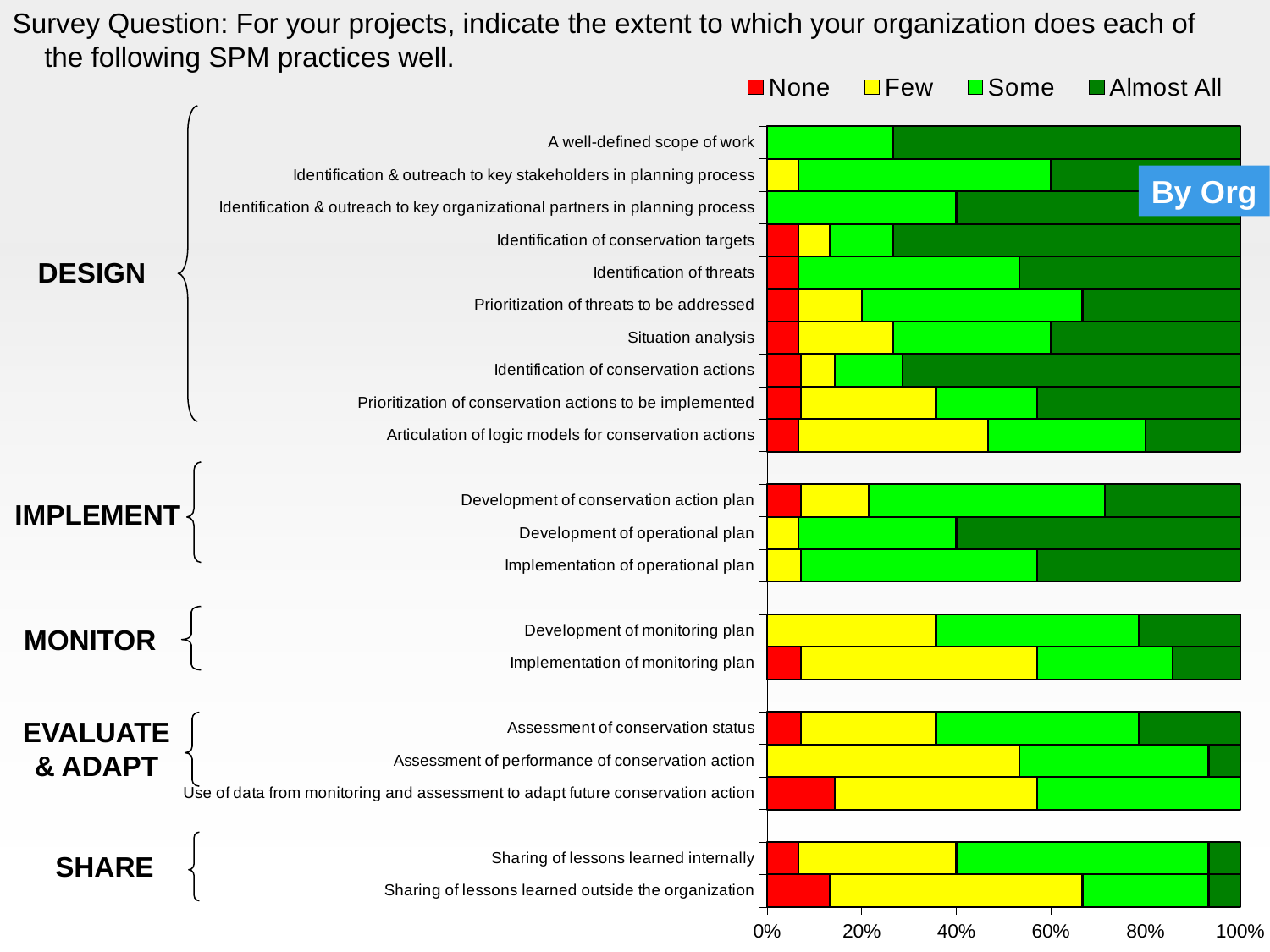
How many series does the legend list? 4 What are the four series listed in the legend? None, Few, Some, Almost All How many SPM practices (bars) are plotted in the chart? 20 Is the 'Few' share for 'Development of monitoring plan' greater or less than 20%? greater Is the 'None' share for 'Use of data from monitoring and assessment to adapt future conservation action' greater or less than 20%? less Which has a larger 'None' share: 'Use of data from monitoring and assessment to adapt future conservation action' or 'Identification of threats'? Use of data from monitoring and assessment to adapt future conservation action What kind of chart is shown on the slide? Stacked bar chart Is the 'Almost All' share for 'A well-defined scope of work' greater or less than 60%? greater What colour represents the 'None' series in the chart? Red Which has a larger 'Almost All' share: 'A well-defined scope of work' or 'Sharing of lessons learned outside the organization'? A well-defined scope of work